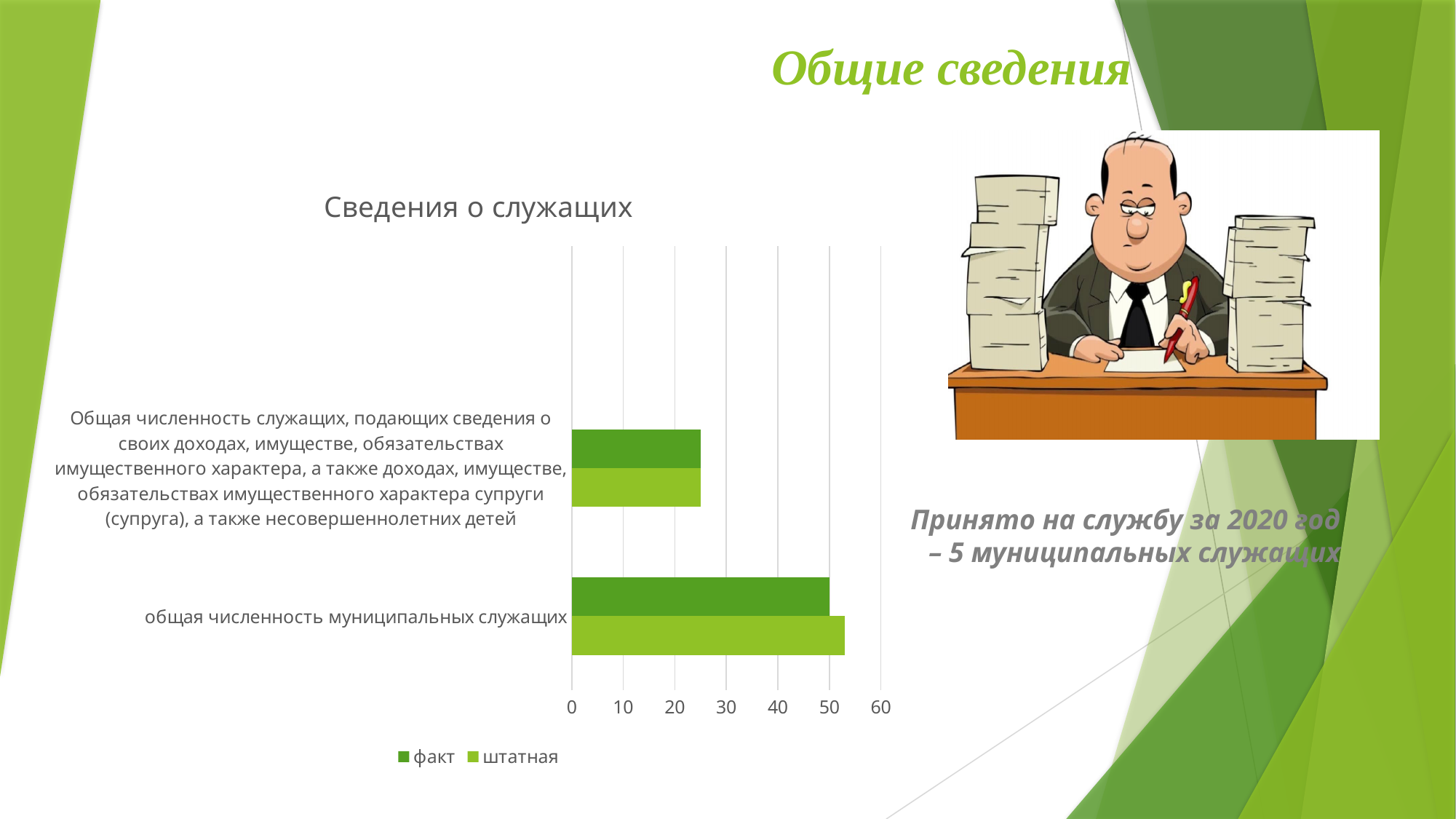
Is the штатная value for "общая численность муниципальных служащих" greater or less than 50? greater What are the names of the series in the chart legend? факт, штатная Which category has the larger values in the chart? общая численность муниципальных служащих What is the title of the chart? Сведения о служащих Is the факт value for "общая численность муниципальных служащих" greater or less than 40? greater Is the факт value for the category about employees submitting income information greater or less than 30? less What type of chart is shown on the slide? bar chart How many series does the chart legend list? 2 How many categories are shown in the chart? 2 For "общая численность муниципальных служащих", which is larger: факт or штатная? штатная